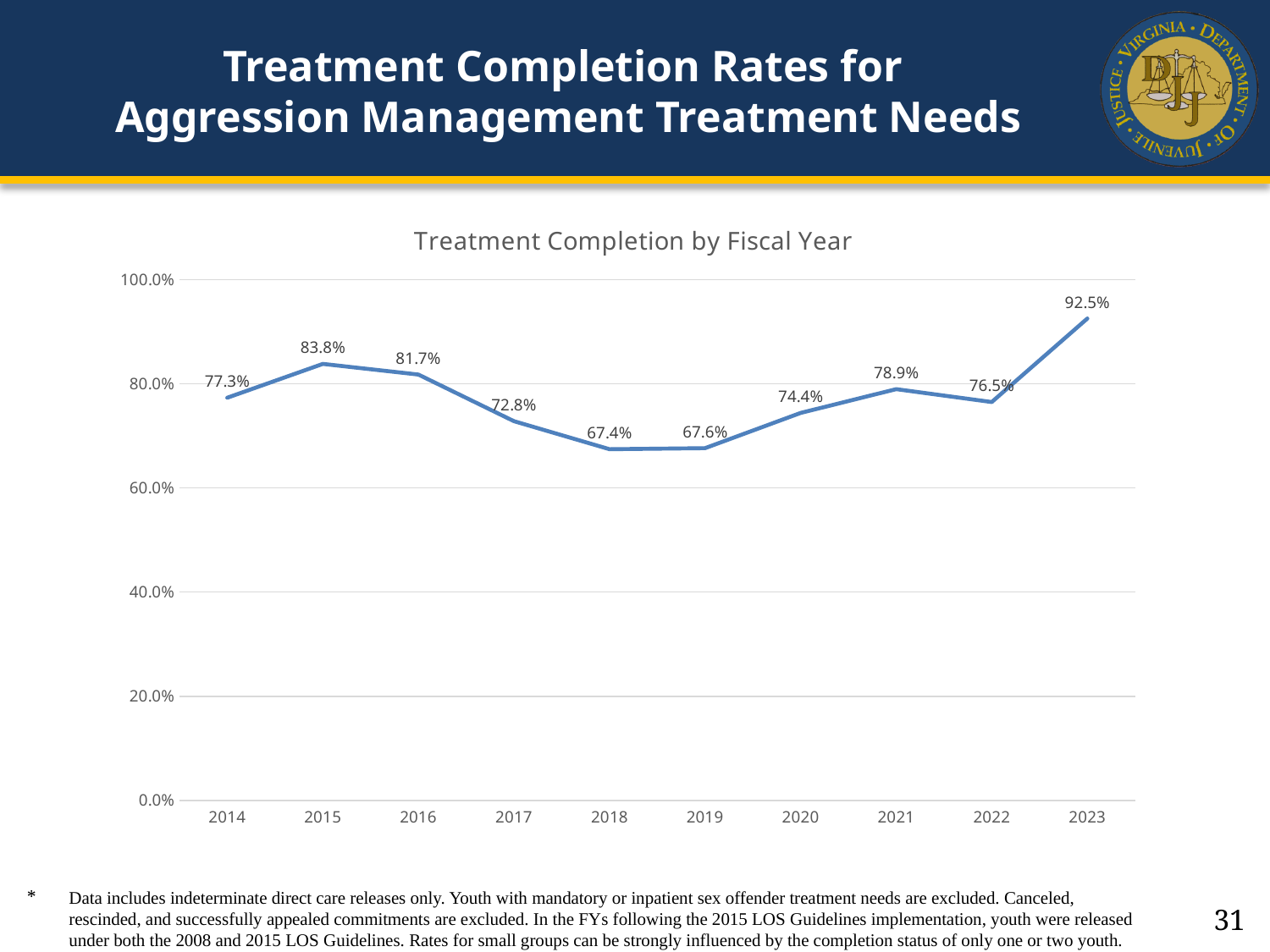
What is the difference between the treatment completion rates for 2023 and 2022? 16.0% Which fiscal year has a higher treatment completion rate, 2016 or 2020? 2016 What kind of chart is shown on the slide? line chart What is the title of the chart? Treatment Completion by Fiscal Year Is the treatment completion rate for 2019 greater or less than 80.0%? less What is the treatment completion rate for fiscal year 2018? 67.4% How many fiscal years are plotted on the chart? 10 What is the difference between the treatment completion rates for 2015 and 2014? 6.5% What is the treatment completion rate for fiscal year 2023? 92.5% What is the treatment completion rate for fiscal year 2015? 83.8% Which fiscal year has the highest treatment completion rate? 2023 Which fiscal year has the lowest treatment completion rate? 2018